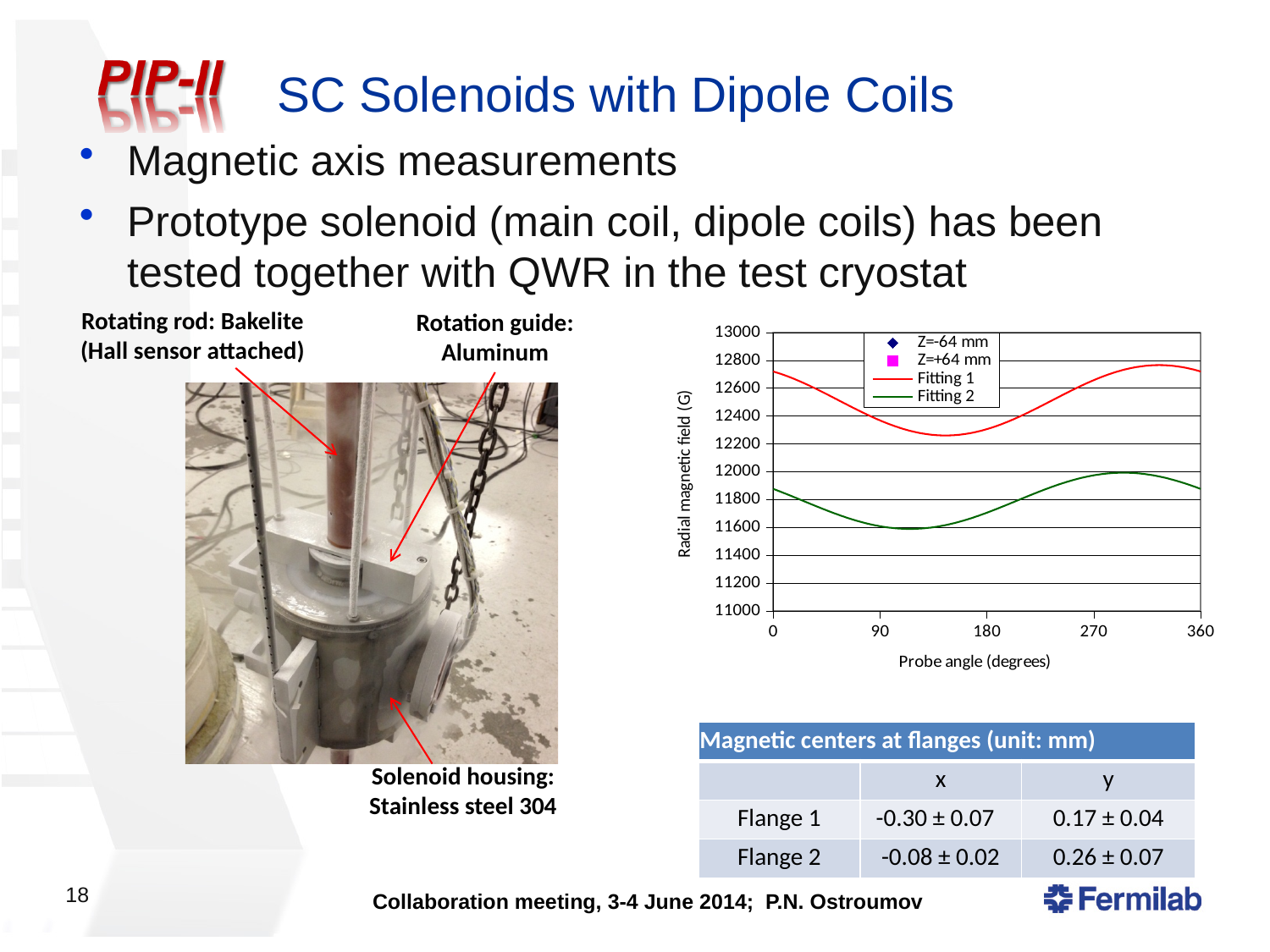
What is the label of the chart's y axis? Radial magnetic field (G) Does the Fitting 2 curve rise or fall as the probe angle goes from 180 to 270 degrees? rise What is the label of the chart's x axis? Probe angle (degrees) Is the value of the Fitting 2 curve at a probe angle of 0 degrees greater or less than 12000? less How many entries does the chart legend list? 4 Is the value of the Fitting 1 curve at a probe angle of 0 degrees greater or less than 12600? greater Is the lowest point of the Fitting 2 curve greater or less than 11800? less What kind of chart is shown on the slide? line chart Does the Fitting 1 curve rise or fall as the probe angle goes from 0 to 90 degrees? fall At a probe angle of 180 degrees, which curve has the larger value, Fitting 1 or Fitting 2? Fitting 1 How many tick labels are shown on the chart's x axis? 5